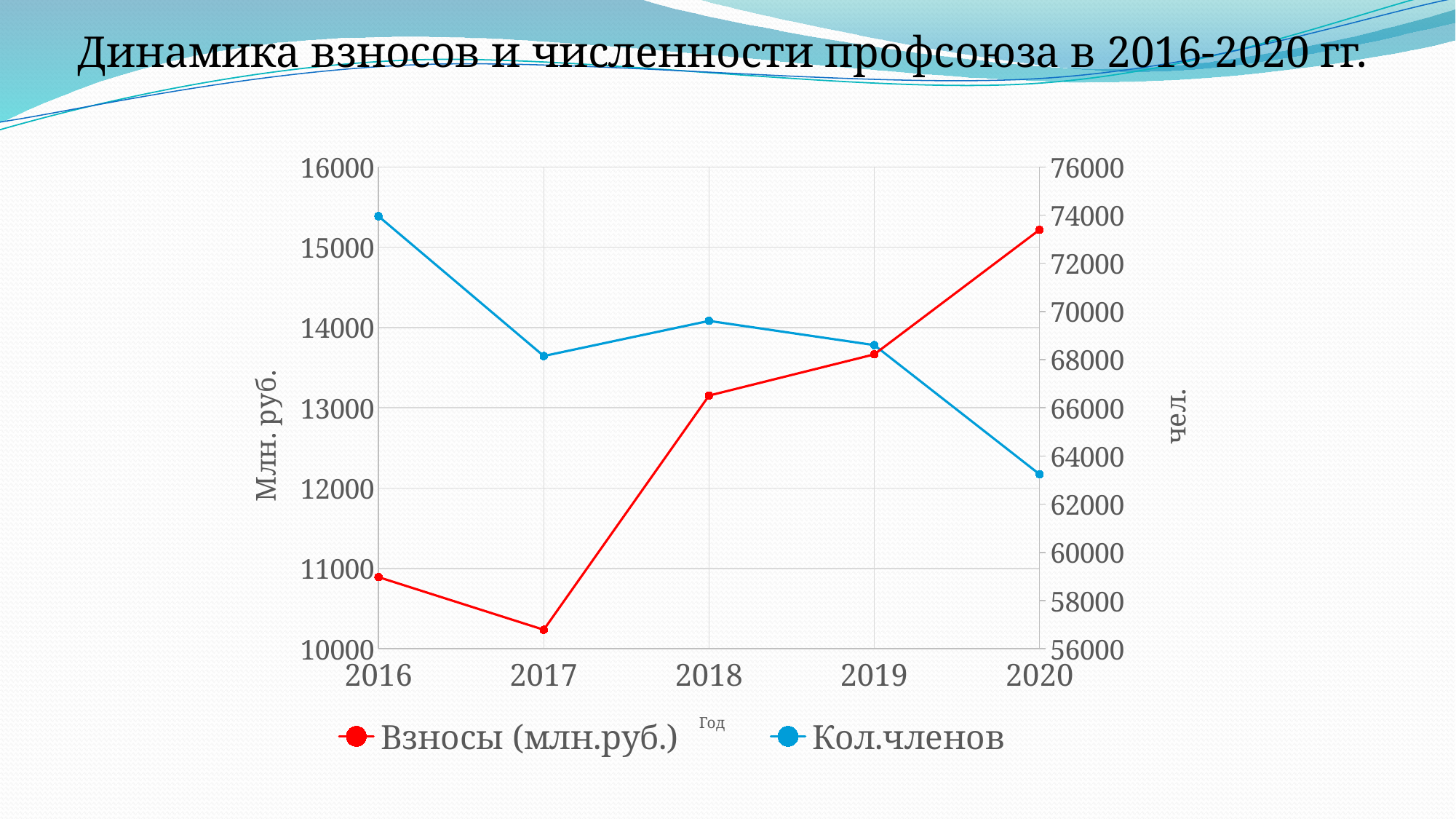
In which year is the value of Взносы (млн.руб.) lowest? 2017 Does Кол.членов rise or fall from 2018 to 2020? fall Is the value of Кол.членов in 2016 greater or less than 72000? greater Which year has the larger value of Взносы (млн.руб.), 2018 or 2019? 2019 Is the value of Взносы (млн.руб.) in 2017 greater or less than 11000? less In which year is Кол.членов highest? 2016 How many years are plotted along the x axis? 5 What kind of chart is shown on the slide? line chart Is the value of Взносы (млн.руб.) in 2020 greater or less than 15000? greater How many series does the legend list? 2 In which year is Кол.членов lowest? 2020 In which year is the value of Взносы (млн.руб.) highest? 2020